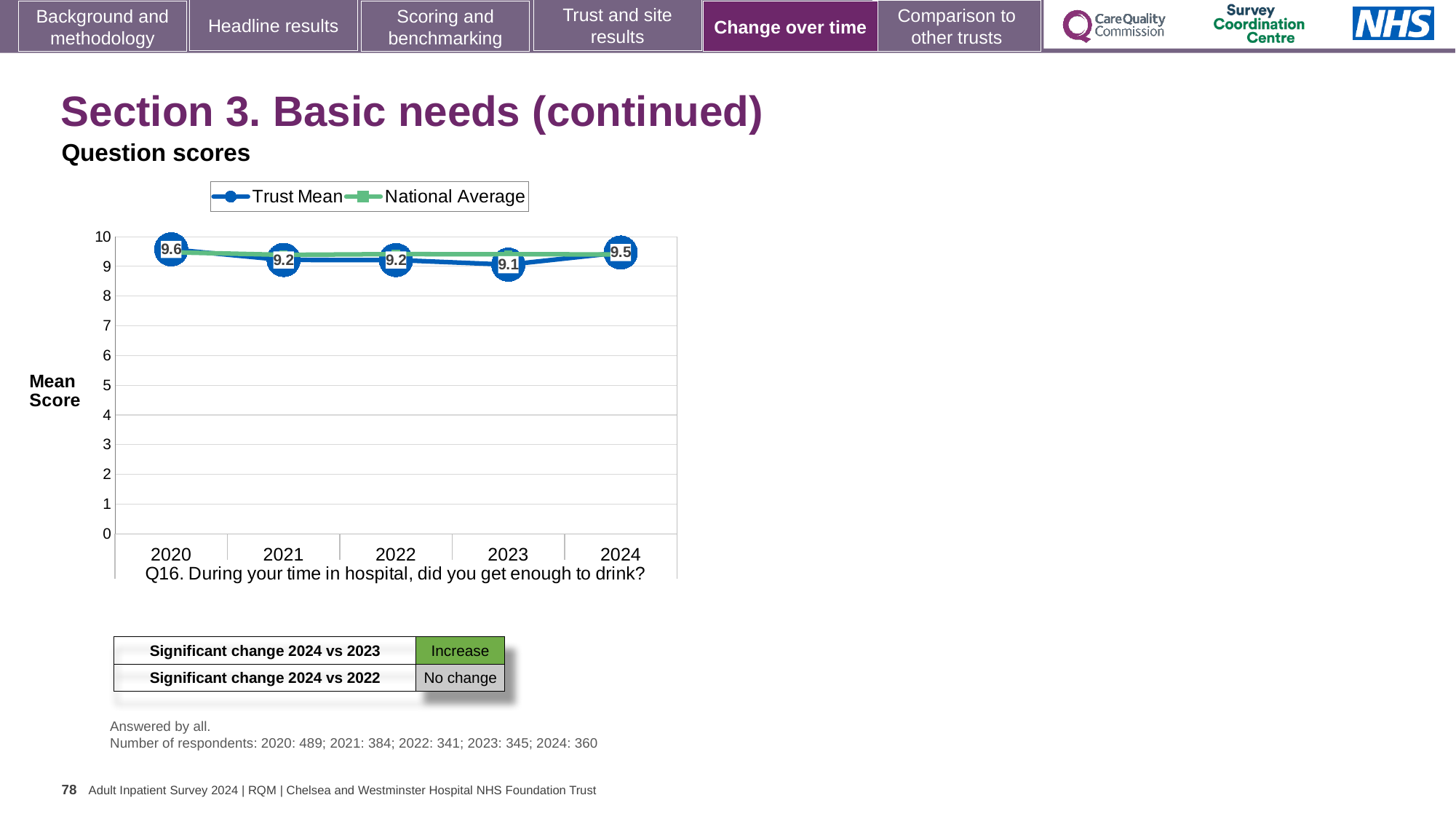
What is the Trust Mean score for 2023? 9.1 How many series does the chart legend list? 2 What kind of chart is shown on the slide? Line chart Is the National Average value for 2024 greater or less than 8? greater What is the Trust Mean score for 2024? 9.5 Which year has the larger Trust Mean score, 2023 or 2024? 2024 In which year is the Trust Mean score lowest? 2023 Does the Trust Mean score rise or fall from 2020 to 2023? Fall In which year is the Trust Mean score highest? 2020 What is the Trust Mean score for 2020? 9.6 What is the difference between the Trust Mean score in 2020 and in 2023? 0.5 How many years are shown on the x axis of the chart? 5